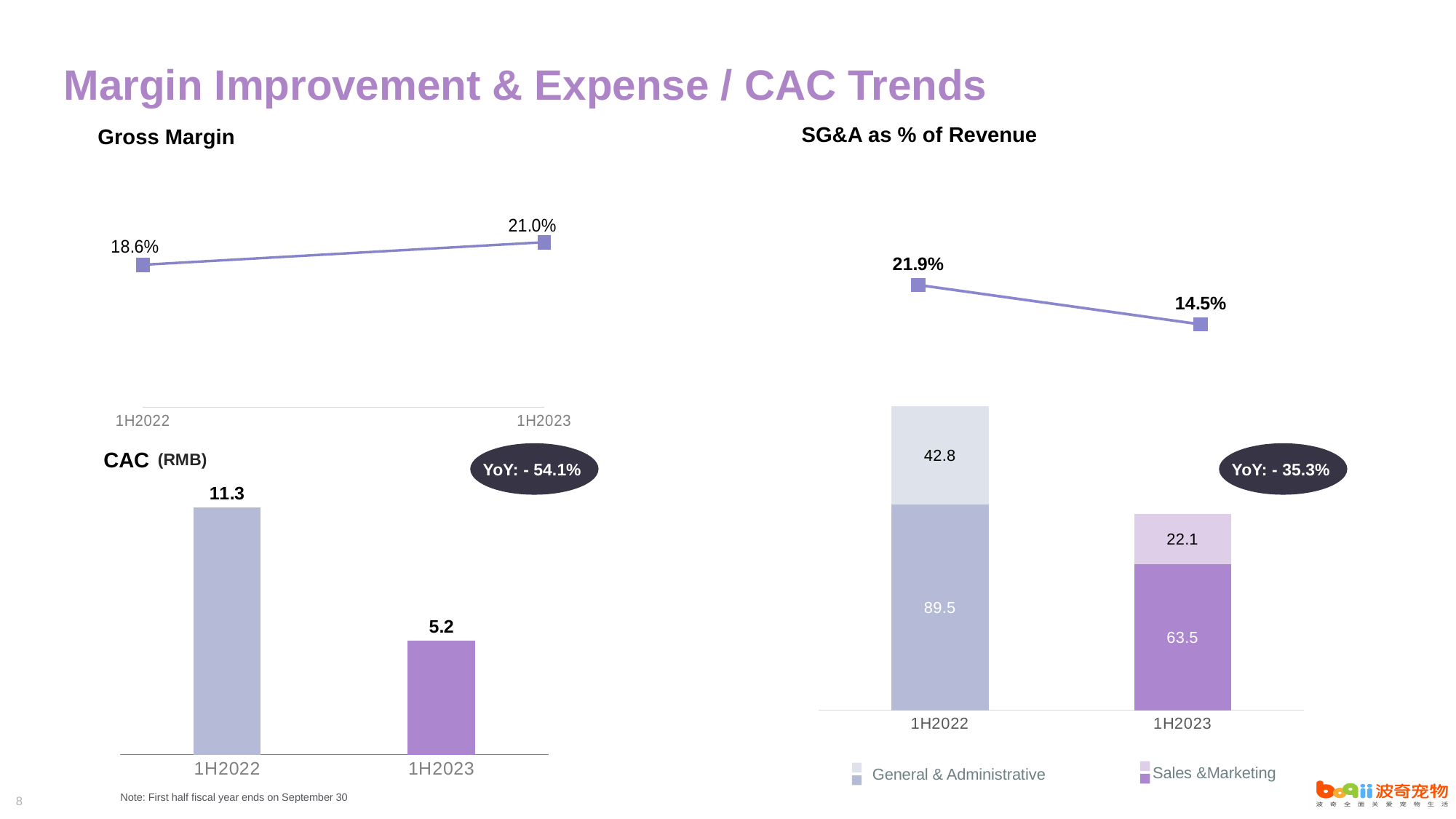
In the Gross Margin chart, do values rise or fall from 1H2022 to 1H2023? rise In the CAC (RMB) chart, what is the value for 1H2022? 11.3 In the SG&A as % of Revenue chart, what is the difference between 1H2022 and 1H2023? 7.4% In the stacked bar chart at the bottom right, what is the total of the 1H2022 bar? 132.3 In the SG&A as % of Revenue chart, what is the value for 1H2023? 14.5% In the SG&A as % of Revenue chart, do values rise or fall from 1H2022 to 1H2023? fall What kind of chart is the CAC (RMB) chart? bar chart In the stacked bar chart at the bottom right, how many series does the legend list? 2 In the Gross Margin chart, what is the value for 1H2022? 18.6% In the Gross Margin chart, what is the value for 1H2023? 21.0% In the CAC (RMB) chart, which period has the lowest value? 1H2023 In the CAC (RMB) chart, what is the difference between 1H2022 and 1H2023? 6.1